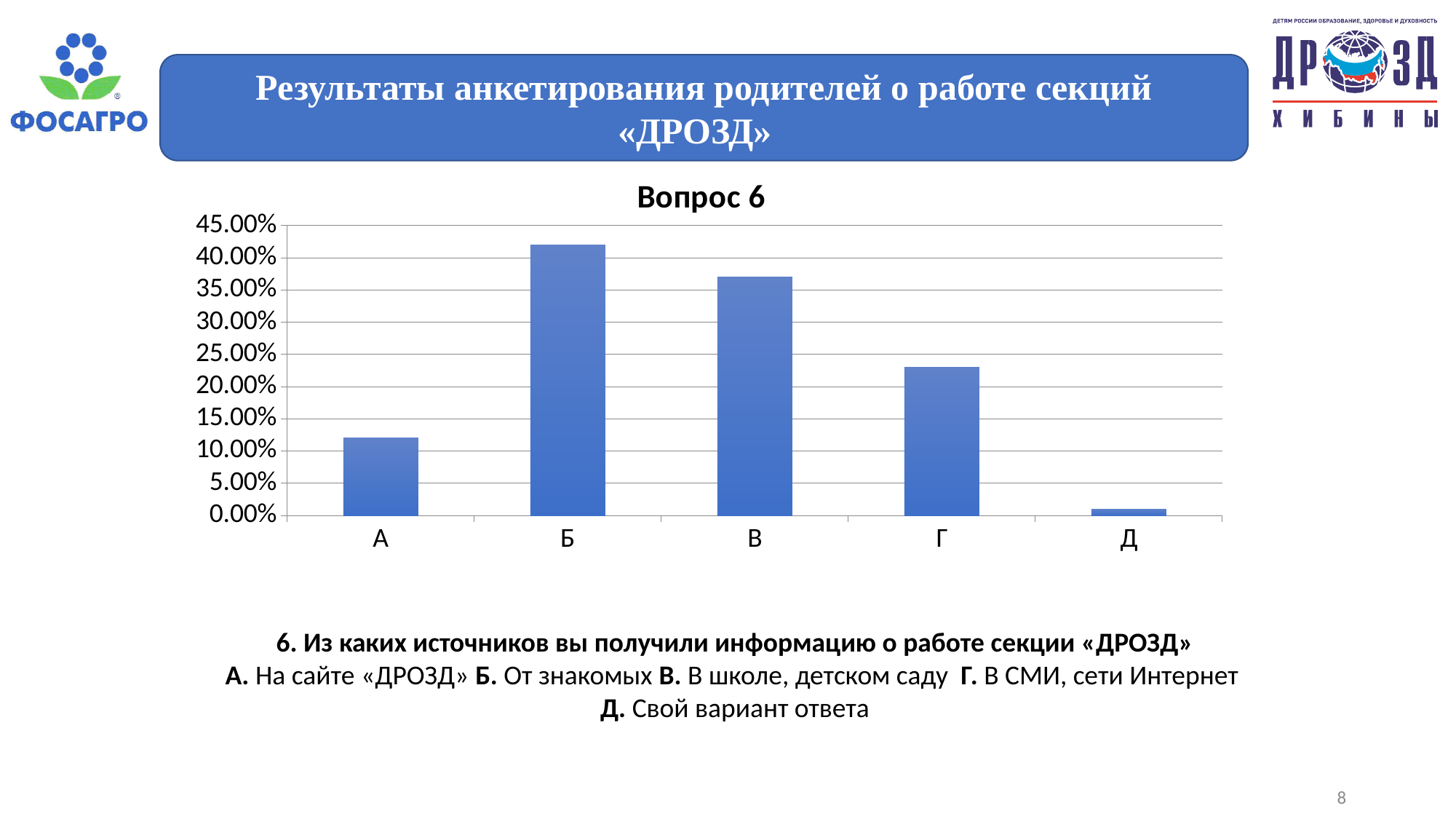
Which is larger in the "Вопрос 6" chart, the value for В or the value for Г? В Is the value for Б in the "Вопрос 6" chart greater or less than 40.00%? greater Is the value for А in the "Вопрос 6" chart greater or less than 10.00%? greater Is the value for Д in the "Вопрос 6" chart greater or less than 5.00%? less How many categories are shown on the x axis of the "Вопрос 6" chart? 5 What kind of chart is shown under the title "Вопрос 6"? bar chart Which category has the highest value in the "Вопрос 6" chart? Б Which category has the lowest value in the "Вопрос 6" chart? Д Which is larger in the "Вопрос 6" chart, the value for А or the value for Г? Г What is the title of the chart on the slide? Вопрос 6